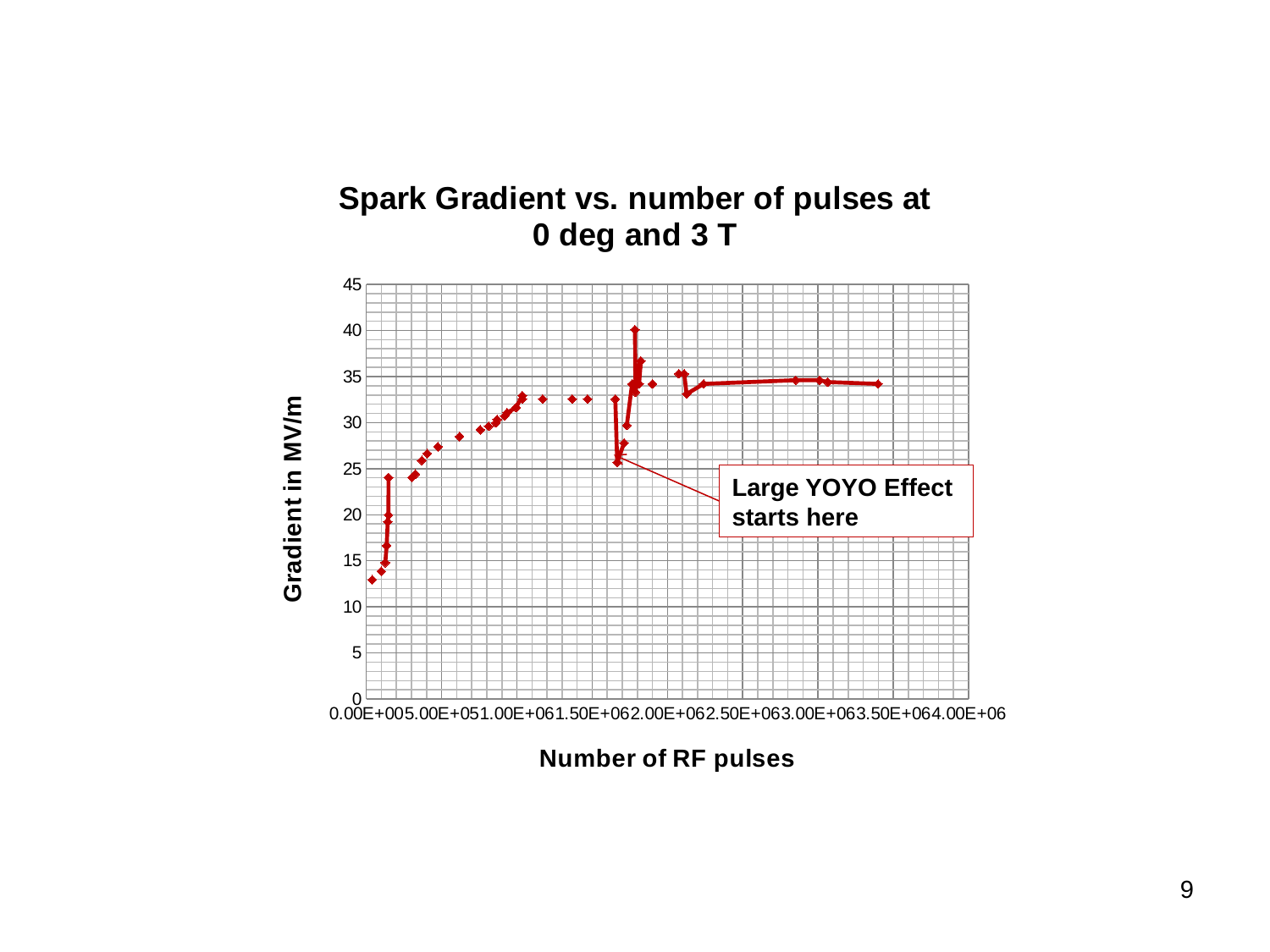
Is the gradient value at about 1.00E+06 RF pulses greater or less than 25? greater Is the highest gradient value plotted on the chart greater or less than 35? greater Is the gradient value at about 3.50E+06 RF pulses greater or less than 30? greater What does the annotation box on the chart say? Large YOYO Effect starts here Overall, does the gradient rise or fall as the number of RF pulses increases? rises What kind of chart is shown on the slide? line chart What is the title of the chart? Spark Gradient vs. number of pulses at 0 deg and 3 T